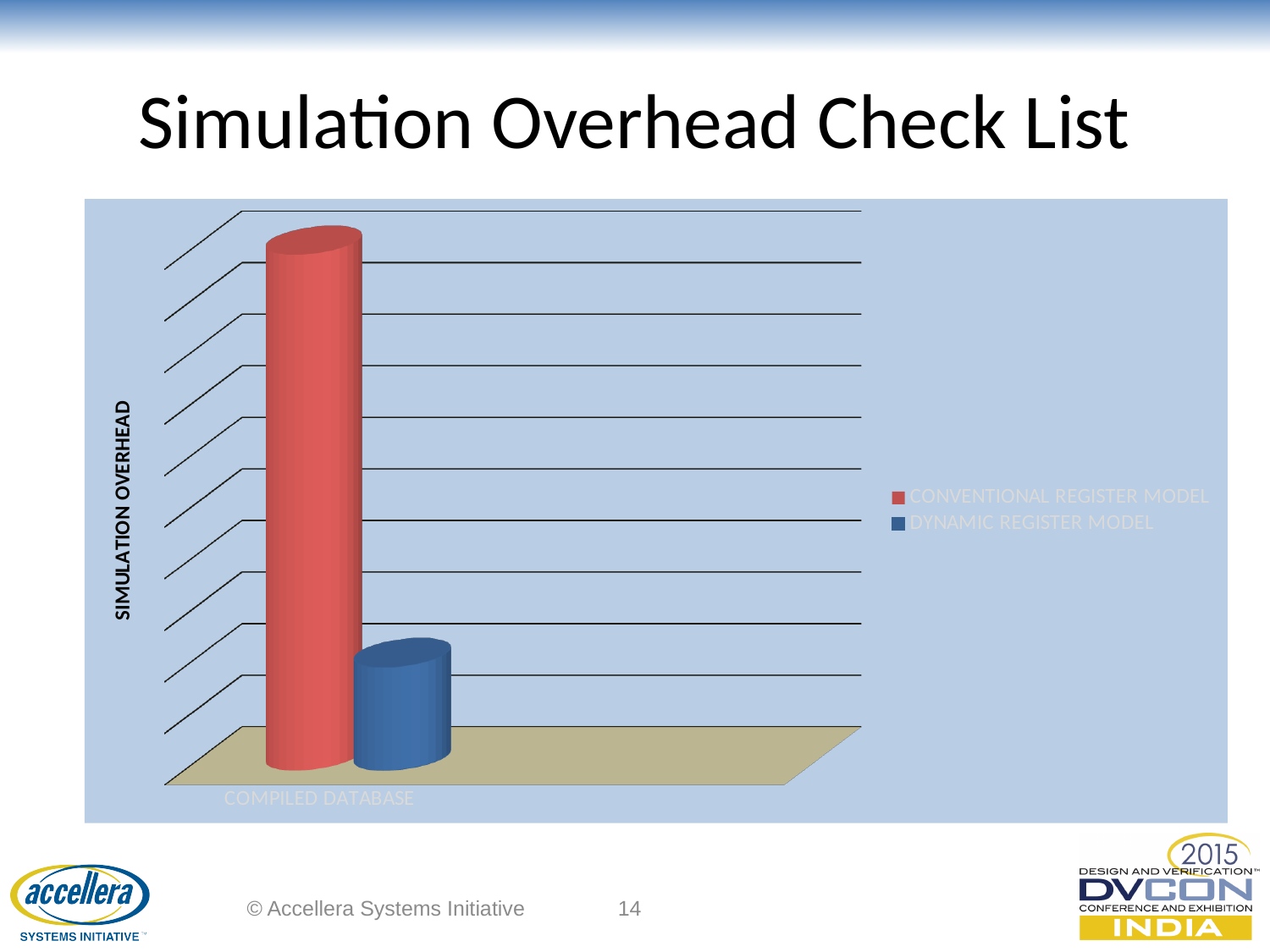
How many series does the legend list? 2 Which series has the tallest bar in the chart? CONVENTIONAL REGISTER MODEL What is the title of the vertical axis? SIMULATION OVERHEAD How many categories are shown on the x axis? 1 Is the bar for DYNAMIC REGISTER MODEL taller or shorter than the bar for CONVENTIONAL REGISTER MODEL? shorter What kind of chart is shown on the slide? bar chart Which series has the lowest bar in the chart? DYNAMIC REGISTER MODEL Which series has the higher value for COMPILED DATABASE? CONVENTIONAL REGISTER MODEL What is the label of the category on the x axis? COMPILED DATABASE